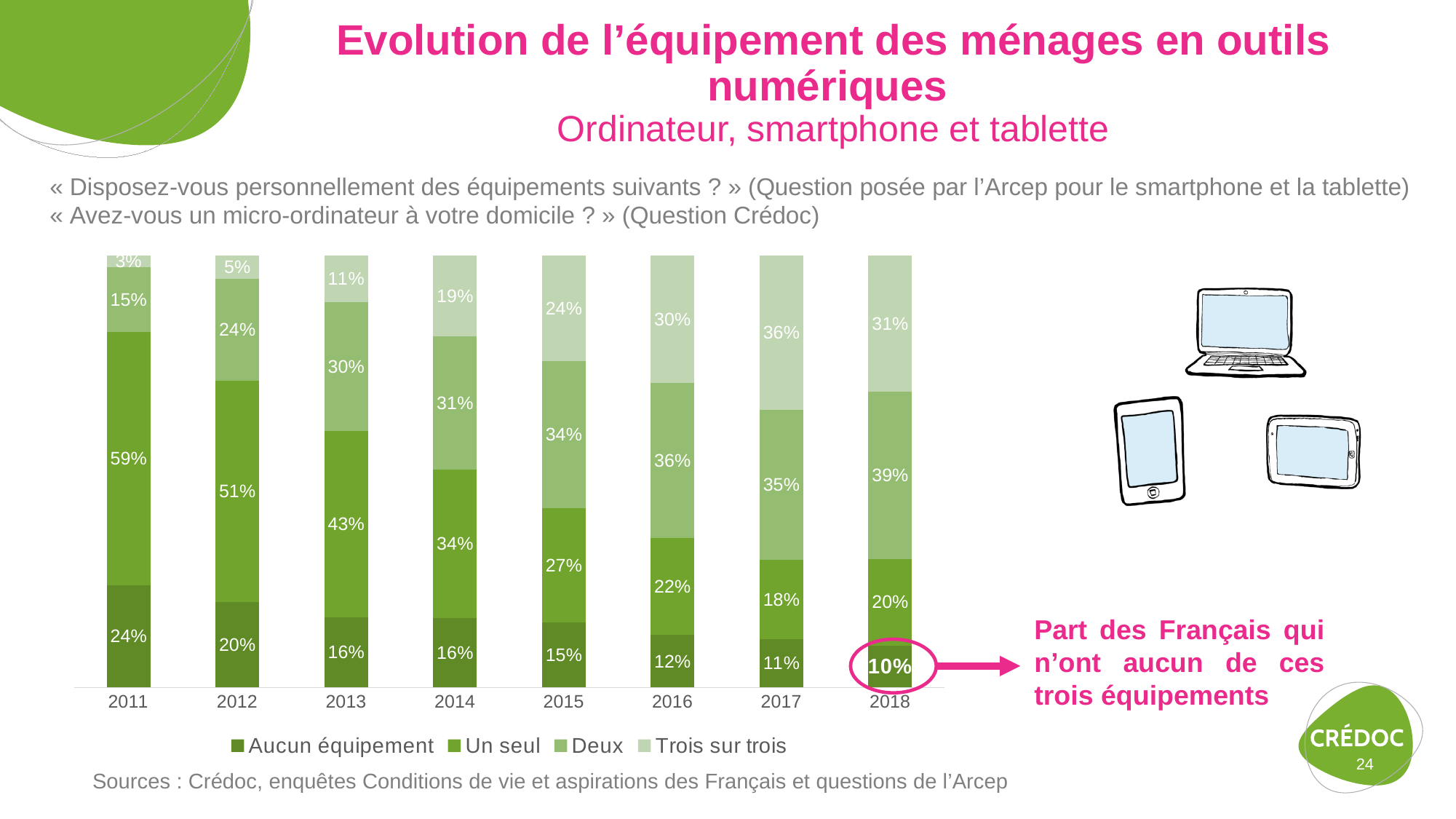
What is the value for "Trois sur trois" in 2016? 30% In which year is the "Aucun équipement" value highest? 2011 How many series does the legend list? 4 Does the "Aucun équipement" value rise or fall from 2011 to 2018? Fall How many years are shown on the x axis? 8 In which year is the "Trois sur trois" value lowest? 2011 Which is larger in 2017: the "Deux" value or the "Un seul" value? Deux What is the difference between the "Un seul" values in 2011 and 2018? 39 percentage points What is the value for "Aucun équipement" in 2018? 10% What kind of chart is shown on the slide? Stacked bar chart What is the value for "Un seul" in 2011? 59% What is the value for "Deux" in 2014? 31%